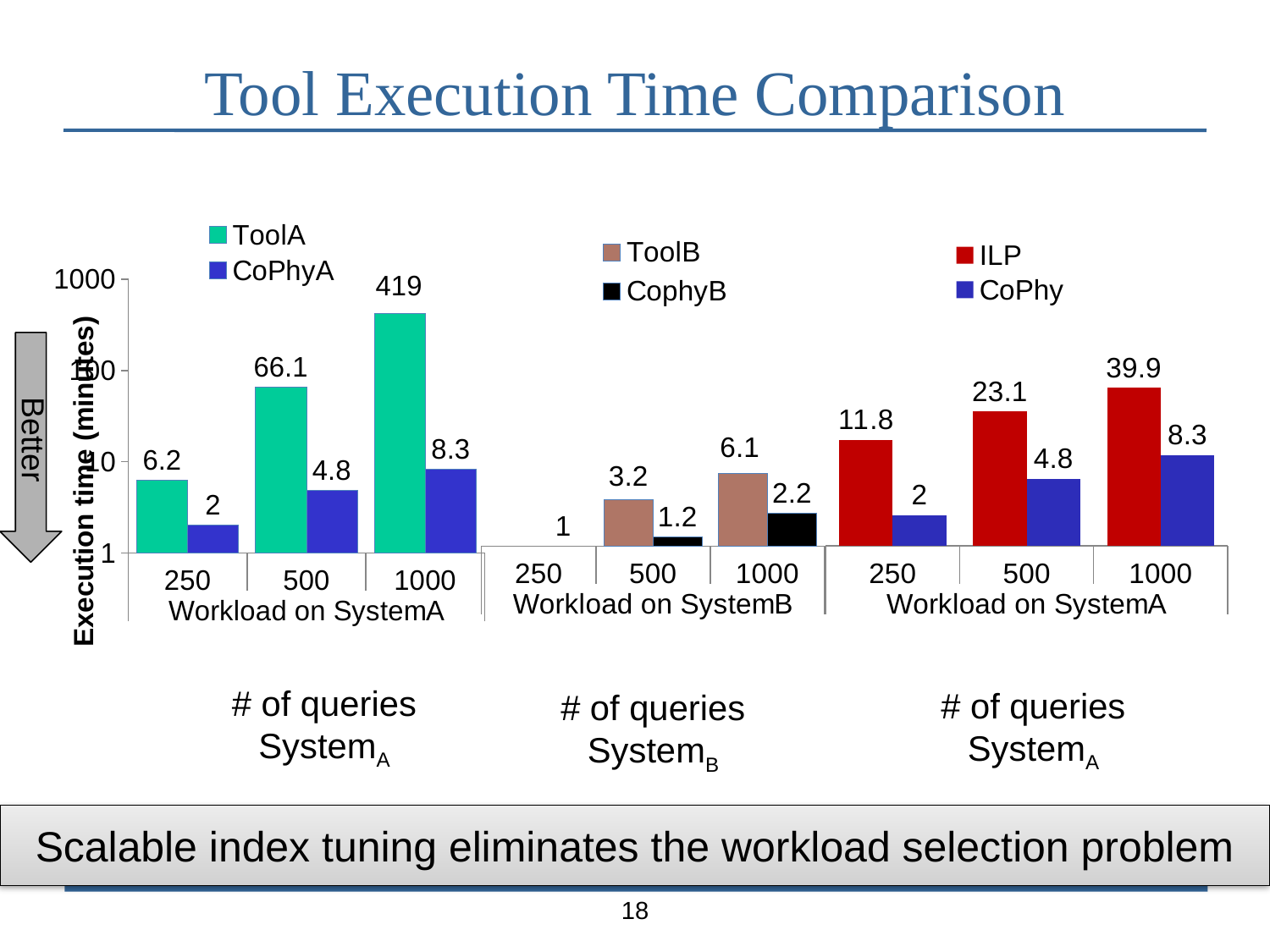
In the left chart (Workload on SystemA, ToolA vs CoPhyA), what is the execution time for CoPhyA at 500 queries? 4.8 In the right chart (ILP vs CoPhy), which workload size has the highest ILP execution time? 1000 In the middle chart (Workload on SystemB), which is larger at 1000 queries: ToolB or CophyB? ToolB How many series does the legend of the right chart (ILP vs CoPhy) list? 2 What kind of chart is used in the left chart (ToolA vs CoPhyA)? bar chart In the right chart (ILP vs CoPhy), what is the difference between ILP and CoPhy execution times at 1000 queries? 31.6 In the left chart (ToolA vs CoPhyA), does ToolA's execution time rise or fall as the number of queries increases? rise In the left chart (ToolA vs CoPhyA), what is the difference between ToolA and CoPhyA execution times at 500 queries? 61.3 In the left chart (Workload on SystemA, ToolA vs CoPhyA), what is the execution time for ToolA at 1000 queries? 419 In the middle chart (Workload on SystemB), what is the execution time for ToolB at 1000 queries? 6.1 In the middle chart (Workload on SystemB), what is the execution time for CophyB at 500 queries? 1.2 In the right chart (ILP vs CoPhy), what is the execution time for ILP at 250 queries? 11.8